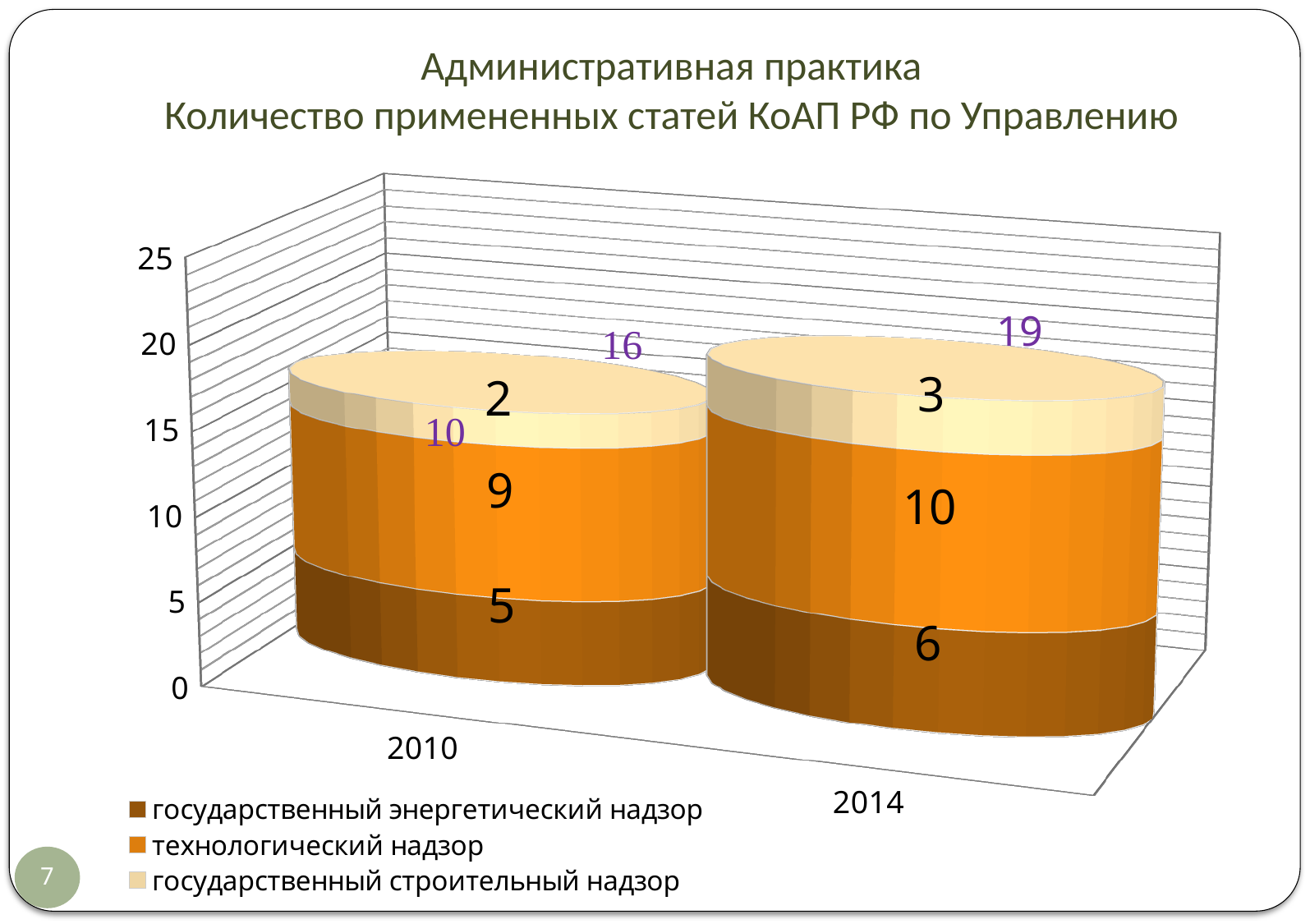
Which year has the larger value for технологический надзор, 2010 or 2014? 2014 What is the value for технологический надзор in 2014? 10 What is the value for технологический надзор in 2010? 9 Which series has the lowest value in 2010? государственный строительный надзор By how much did the value for государственный энергетический надзор change from 2010 to 2014? 1 What is the total of the stacked bar for 2010? 16 What is the value for государственный строительный надзор in 2014? 3 What is the total of the stacked bar for 2014? 19 How many series does the legend list? 3 How many categories are shown on the x axis? 2 What kind of chart is shown on the slide? stacked bar chart What is the value for государственный энергетический надзор in 2010? 5